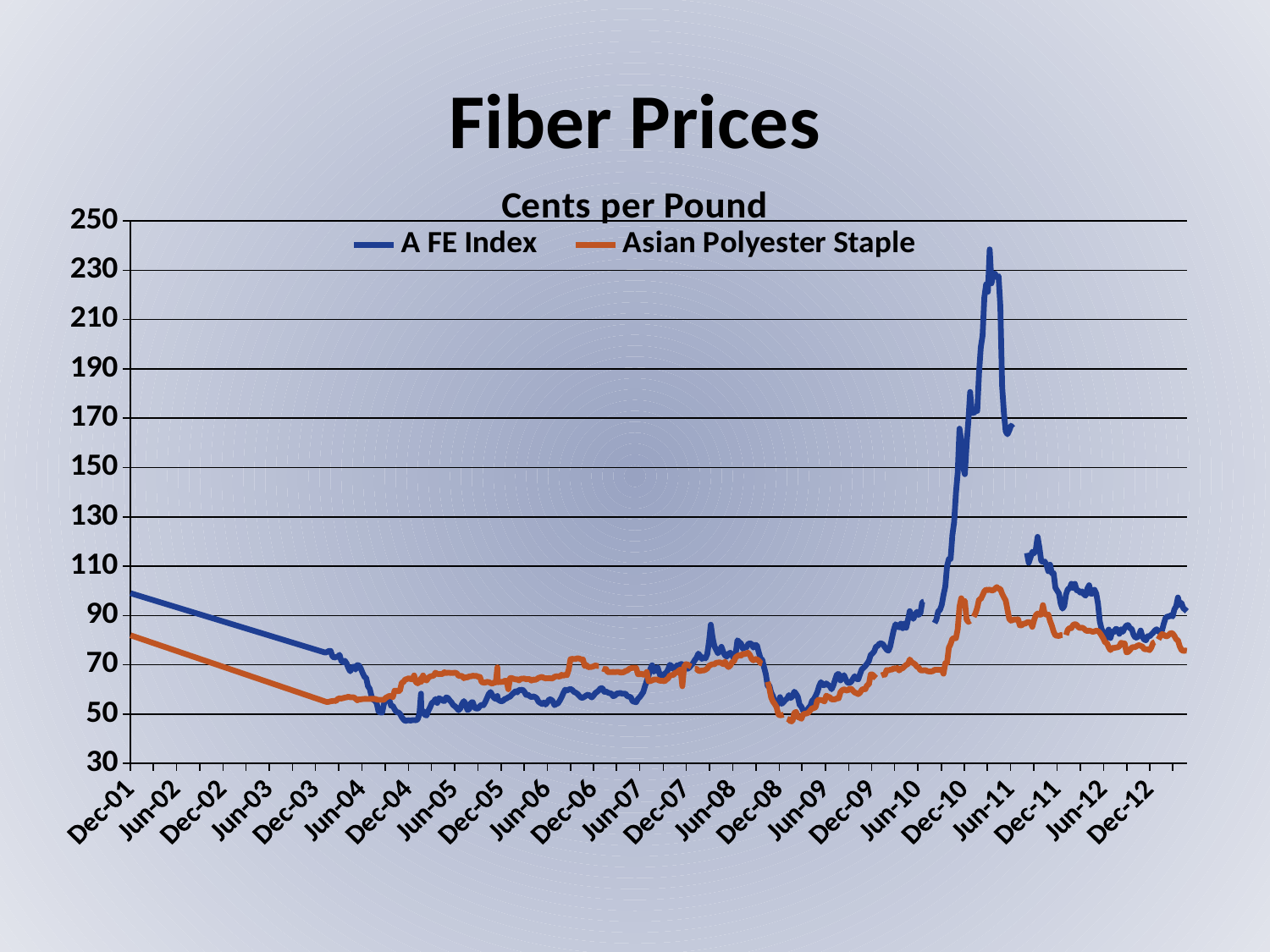
Which series is drawn in orange? Asian Polyester Staple Is the peak value of the A FE Index around Jun-11 greater or less than 210? greater How many series does the legend list? 2 What kind of chart is shown on the slide? line chart What is the title of the chart? Cents per Pound How many date labels are shown on the x axis? 23 Is the peak value of Asian Polyester Staple around Jun-11 greater or less than 110? less Which series reaches the highest value on the chart? A FE Index At Dec-01, which series has the higher value, A FE Index or Asian Polyester Staple? A FE Index Is the value of Asian Polyester Staple at Dec-08 greater or less than 70? less Does the A FE Index rise or fall between Dec-01 and Dec-03? fall